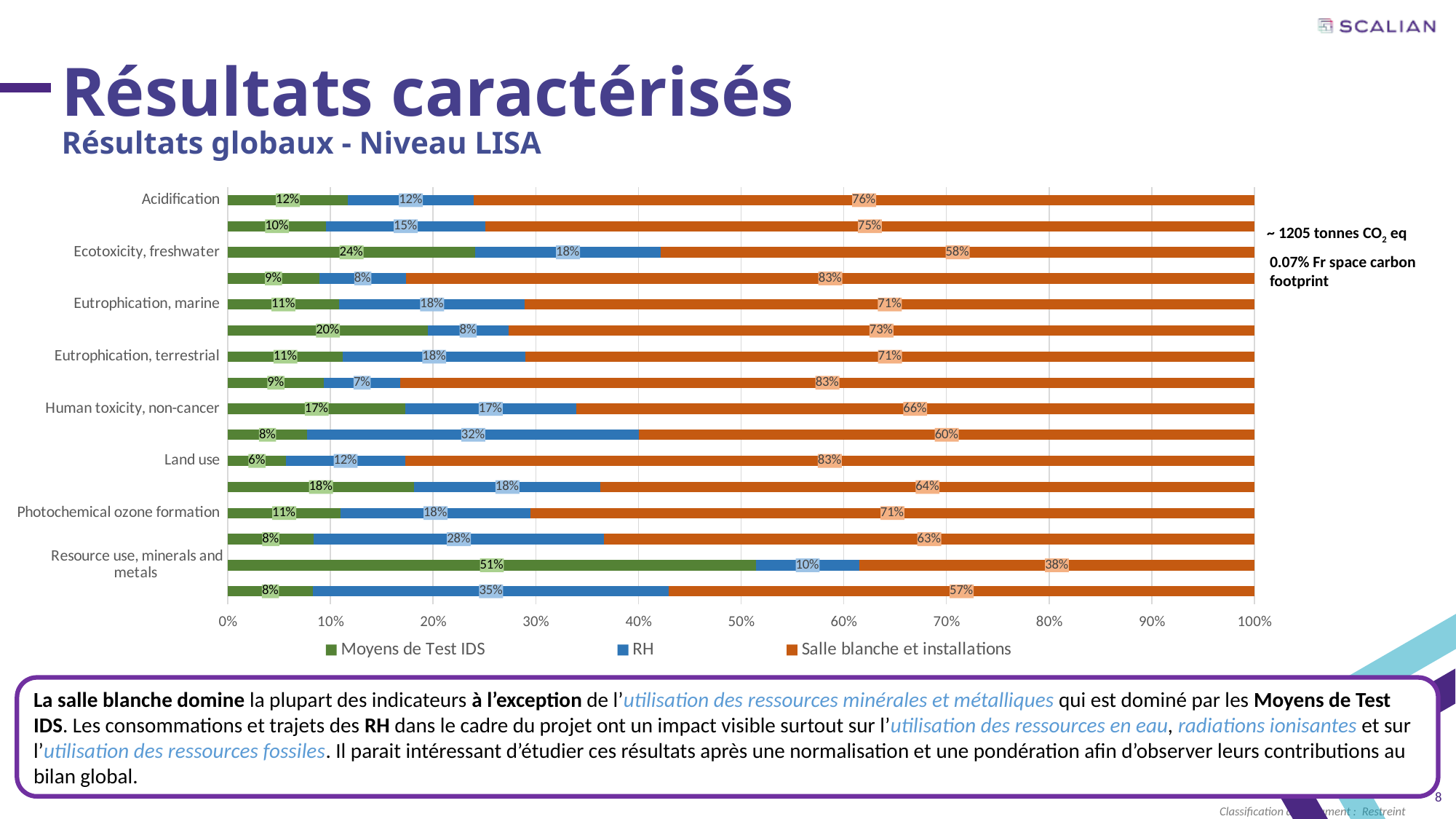
What is the value of Salle blanche et installations for Acidification? 76% Which labelled category has the lowest Salle blanche et installations share? Resource use, minerals and metals What is the difference between the Salle blanche et installations values for Land use and Human toxicity, non-cancer? 17% Which is larger: the Moyens de Test IDS value for Ecotoxicity, freshwater or for Acidification? Ecotoxicity, freshwater What is the value of Moyens de Test IDS for Land use? 6% What are the three series named in the legend? Moyens de Test IDS, RH, Salle blanche et installations What is the value of RH for Ecotoxicity, freshwater? 18% How many series does the legend list? 3 What is the value of Moyens de Test IDS for Resource use, minerals and metals? 51% Which labelled category has the highest Moyens de Test IDS share? Resource use, minerals and metals What kind of chart is shown on the slide? Stacked bar chart How many bars are plotted in the chart? 16